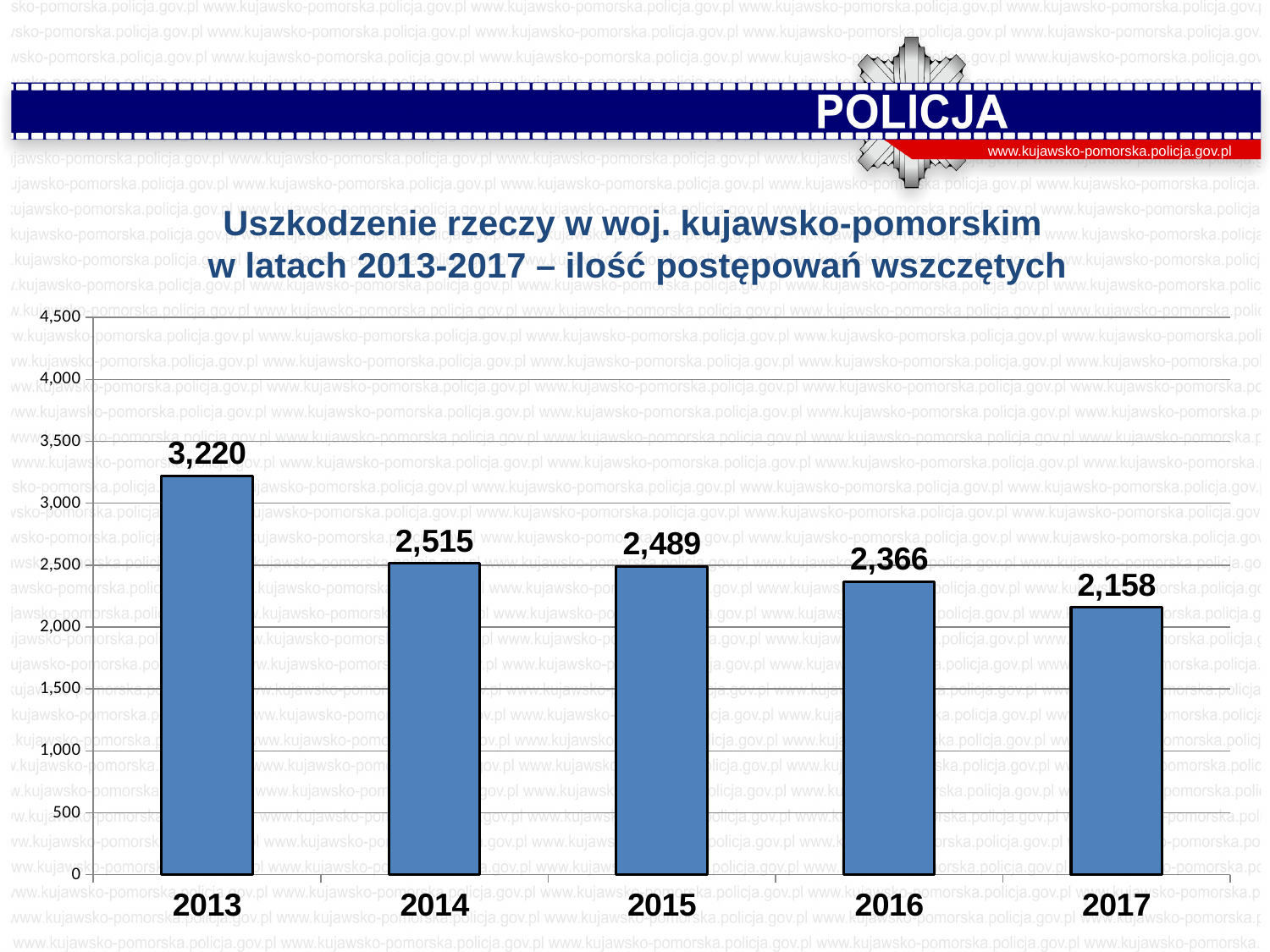
Do the values rise or fall from 2013 to 2017? fall Which year has the lowest value? 2017 Which year has the highest value? 2013 What is the difference between the values for 2016 and 2017? 208 Which is larger, the value for 2014 or the value for 2016? 2014 What is the difference between the values for 2013 and 2014? 705 What is the value for 2017? 2,158 What is the value for 2013? 3,220 What is the value for 2015? 2,489 Is the value for 2013 greater or less than 3,000? greater How many years are shown on the chart? 5 What kind of chart is shown on the slide? bar chart